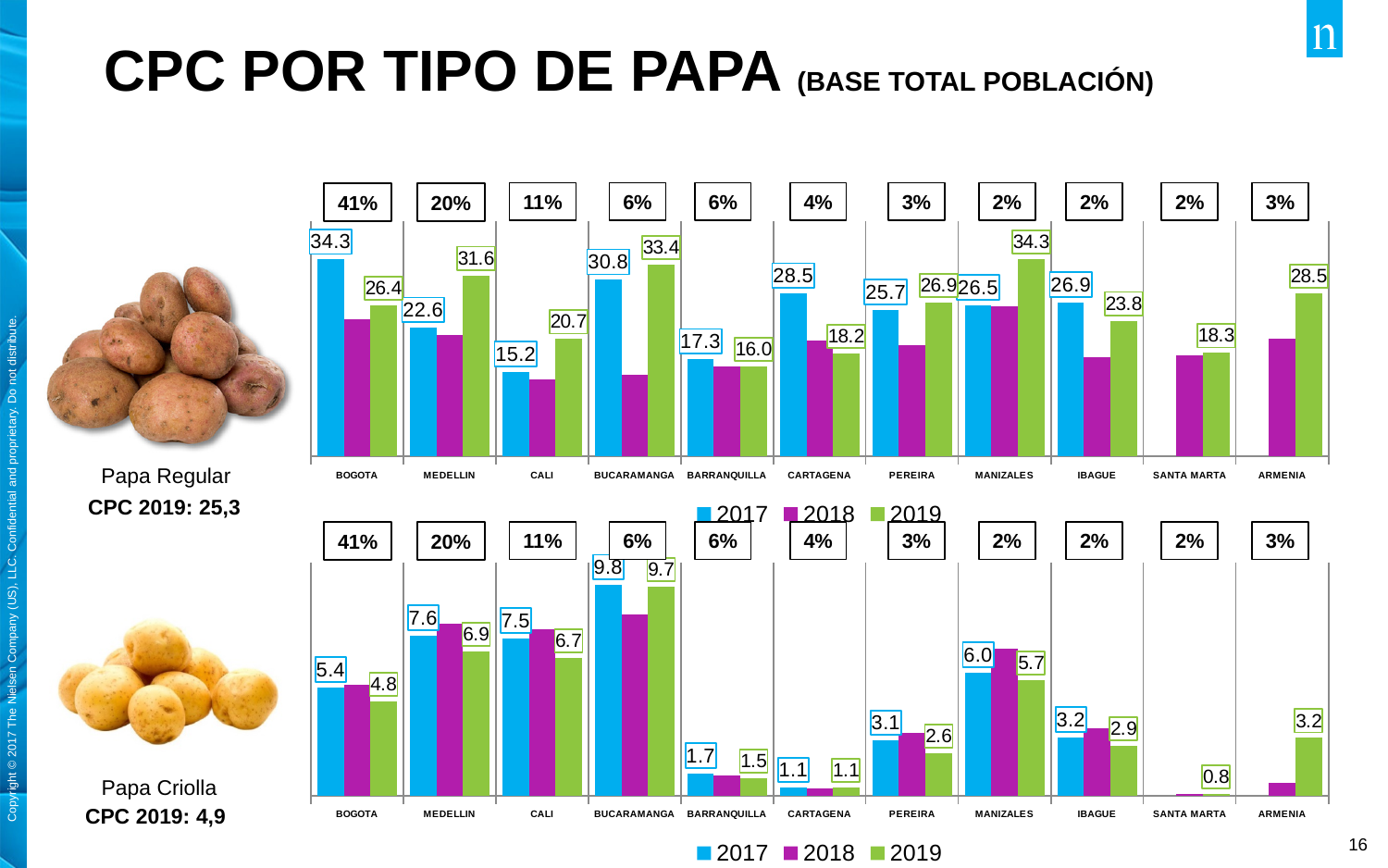
How many series does the legend of the Papa Criolla chart (bottom) list? 3 In the Papa Criolla chart (bottom), which city has the highest 2017 value? BUCARAMANGA In the Papa Criolla chart (bottom), what is the difference between the 2017 and 2019 values for MEDELLIN? 0.7 In the Papa Regular chart (top), is the 2019 value for BUCARAMANGA larger than the 2017 value? Yes How many cities are shown on the x axis of the Papa Regular chart (top)? 11 In the Papa Regular chart (top), what is the difference between the 2017 and 2019 values for CARTAGENA? 10.3 In the Papa Regular chart (top), what is the 2019 value for MEDELLIN? 31.6 In the Papa Regular chart (top), what is the 2017 value for BOGOTA? 34.3 In the Papa Criolla chart (bottom), what is the 2017 value for BUCARAMANGA? 9.8 What type of chart is the Papa Regular chart (top)? Bar chart In the Papa Criolla chart (bottom), which city has the lowest 2019 value? SANTA MARTA In the Papa Regular chart (top), which city has the highest 2019 value? MANIZALES